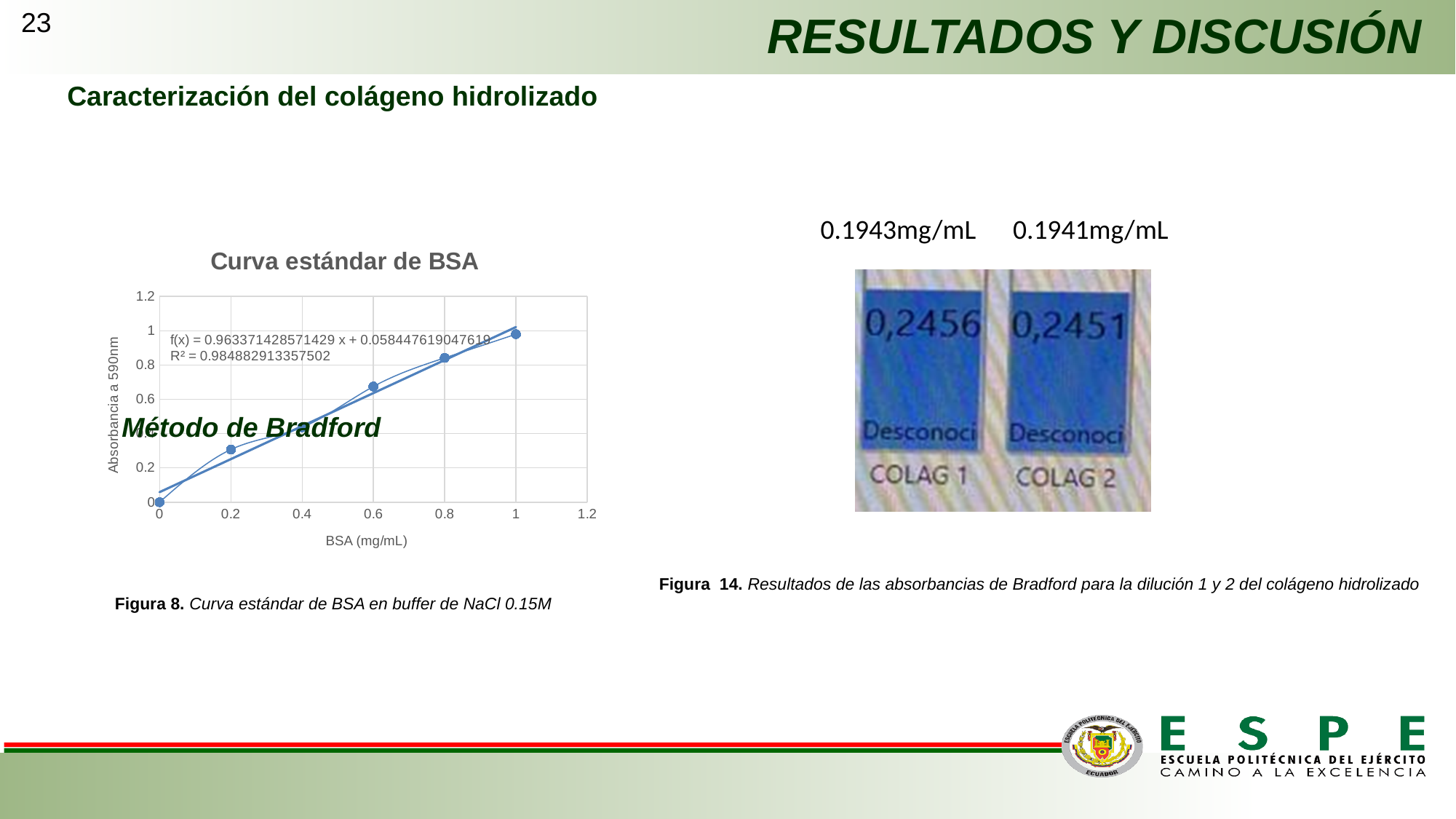
Do the absorbance values rise or fall as BSA concentration increases along the x axis? rise At which BSA concentration is the absorbance highest? 1 What is the R² value printed on the chart? 0.984882913357502 Is the absorbance at BSA 0.2 mg/mL greater or less than 0.4? less What is the trendline equation printed on the chart? f(x) = 0.963371428571429 x + 0.058447619047619 Which has the larger absorbance, BSA 0.8 mg/mL or BSA 0.2 mg/mL? 0.8 mg/mL Is the absorbance at BSA 0.8 mg/mL greater or less than 0.6? greater What is the title of the chart on the slide? Curva estándar de BSA Is the absorbance at BSA 1 mg/mL greater or less than 0.8? greater At which BSA concentration is the absorbance lowest? 0 What kind of chart is "Curva estándar de BSA"? scatter chart with a trendline What is the label of the x axis of the chart? BSA (mg/mL)